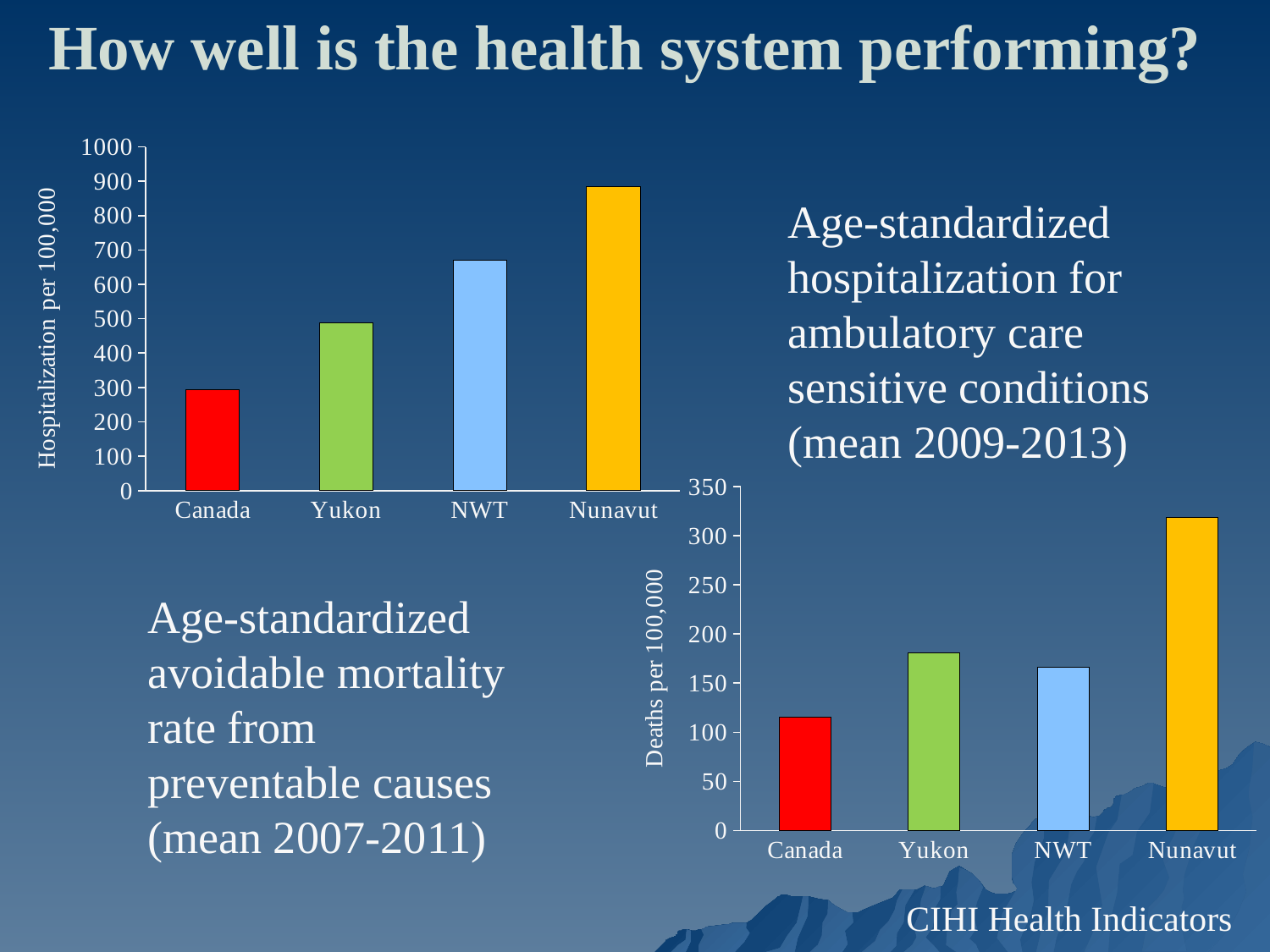
In the hospitalization for ambulatory care sensitive conditions chart (top left), which category has the lowest value? Canada In the avoidable mortality rate chart (bottom right), is the value for Canada greater or less than 150? less In the avoidable mortality rate chart (bottom right), is the value for Nunavut greater or less than 300? greater In the hospitalization for ambulatory care sensitive conditions chart (top left), which category has the highest value? Nunavut In the hospitalization for ambulatory care sensitive conditions chart (top left), is the value for NWT greater or less than 600? greater What is the y-axis title of the avoidable mortality rate chart (bottom right)? Deaths per 100,000 In the avoidable mortality rate chart (bottom right), which category has the lowest value? Canada In the avoidable mortality rate chart (bottom right), which category has the highest value? Nunavut In the hospitalization for ambulatory care sensitive conditions chart (top left), do the values rise or fall from Canada to Nunavut along the x axis? rise In the avoidable mortality rate chart (bottom right), how many categories are shown on the x axis? 4